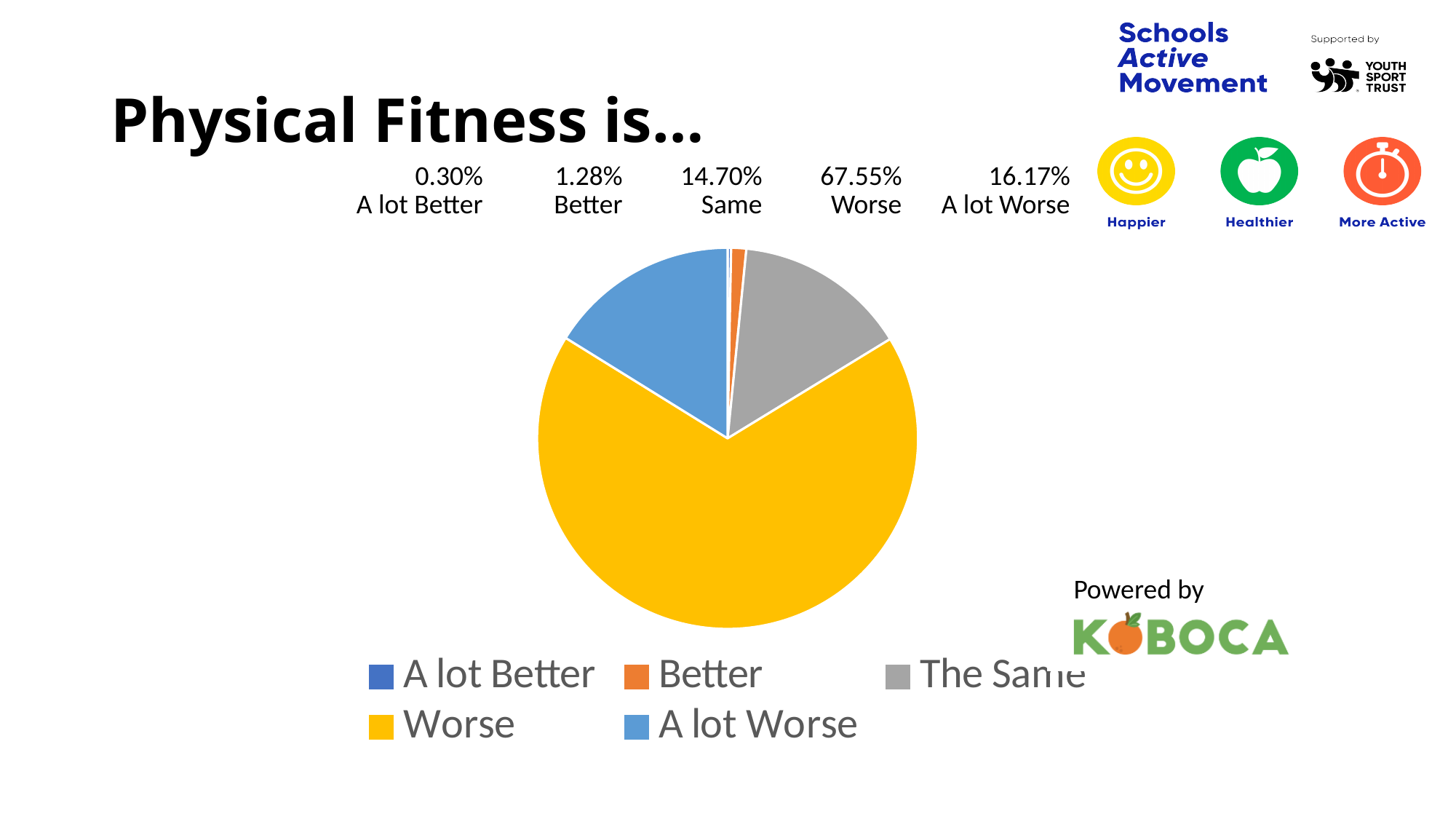
Which category has the smallest share of the pie? A lot Better What kind of chart is shown on the slide? pie chart Which is larger, the share for A lot Worse or the share for Same? A lot Worse What colour is the Worse slice of the pie? yellow What percentage of responses say physical fitness is Better? 1.28% What is the difference in percentage points between Worse and A lot Worse? 51.38% What percentage of responses say physical fitness is the Same? 14.70% What percentage of responses say physical fitness is A lot Better? 0.30% Which category has the largest share of the pie? Worse What percentage of responses say physical fitness is Worse? 67.55% How many categories does the legend list? 5 What percentage of responses say physical fitness is A lot Worse? 16.17%